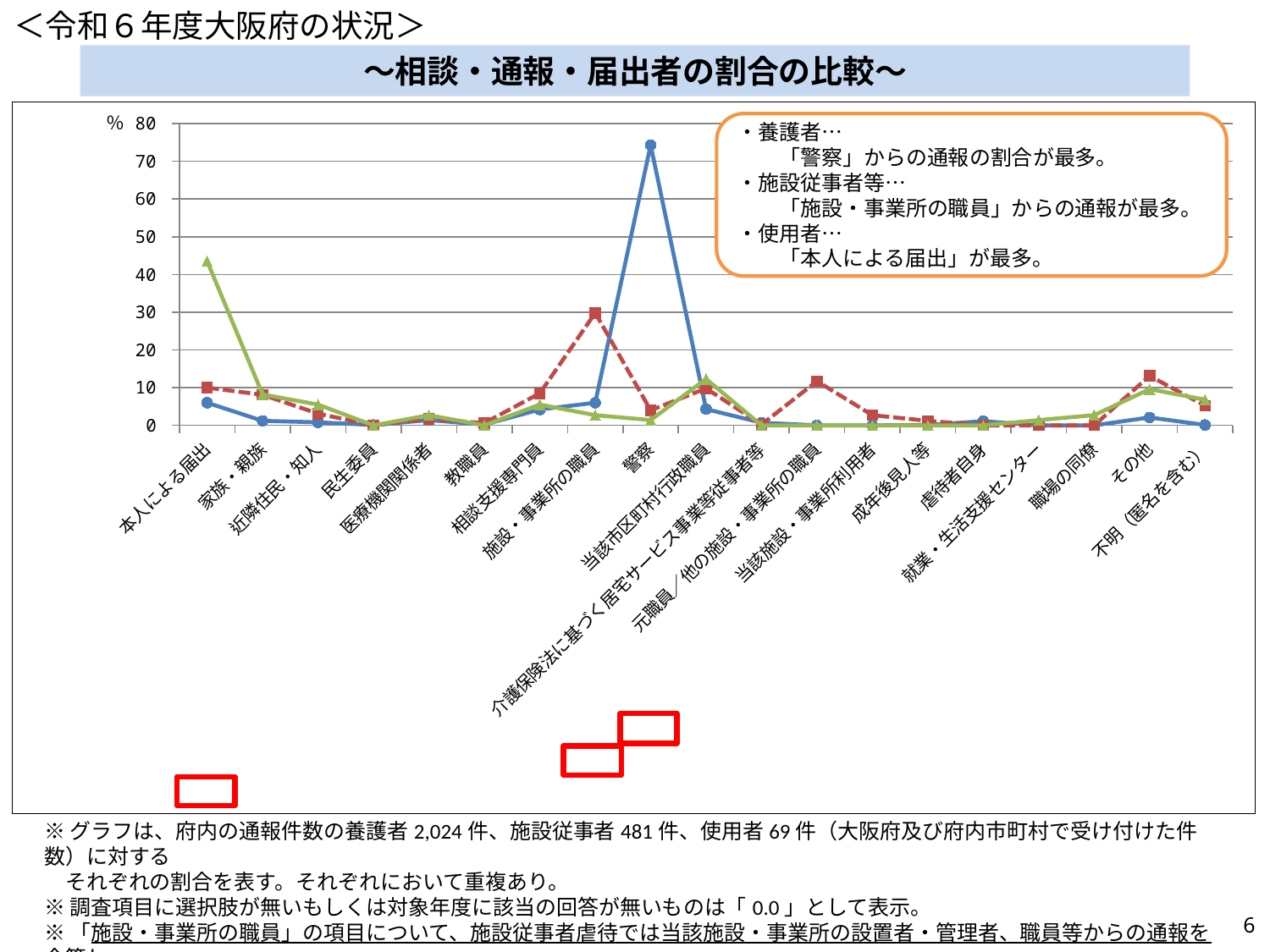
At 警察, which line has the larger value, the blue line or the red dashed line? blue line At which category does the red dashed line reach its highest value? 施設・事業所の職員 What kind of chart is shown on the slide? line chart How many categories are shown along the x axis of the chart? 19 Is the value of the red dashed line at 施設・事業所の職員 greater or less than 20? greater At which category does the green solid line reach its highest value? 本人による届出 Is the value of the blue line at 警察 greater or less than 70? greater What is the title of the chart? ～相談・通報・届出者の割合の比較～ At which category does the blue solid line reach its highest value? 警察 How many lines (data series) are plotted on the chart? 3 What unit is shown at the top of the vertical axis? % Is the value of the green line at 本人による届出 greater or less than 40? greater